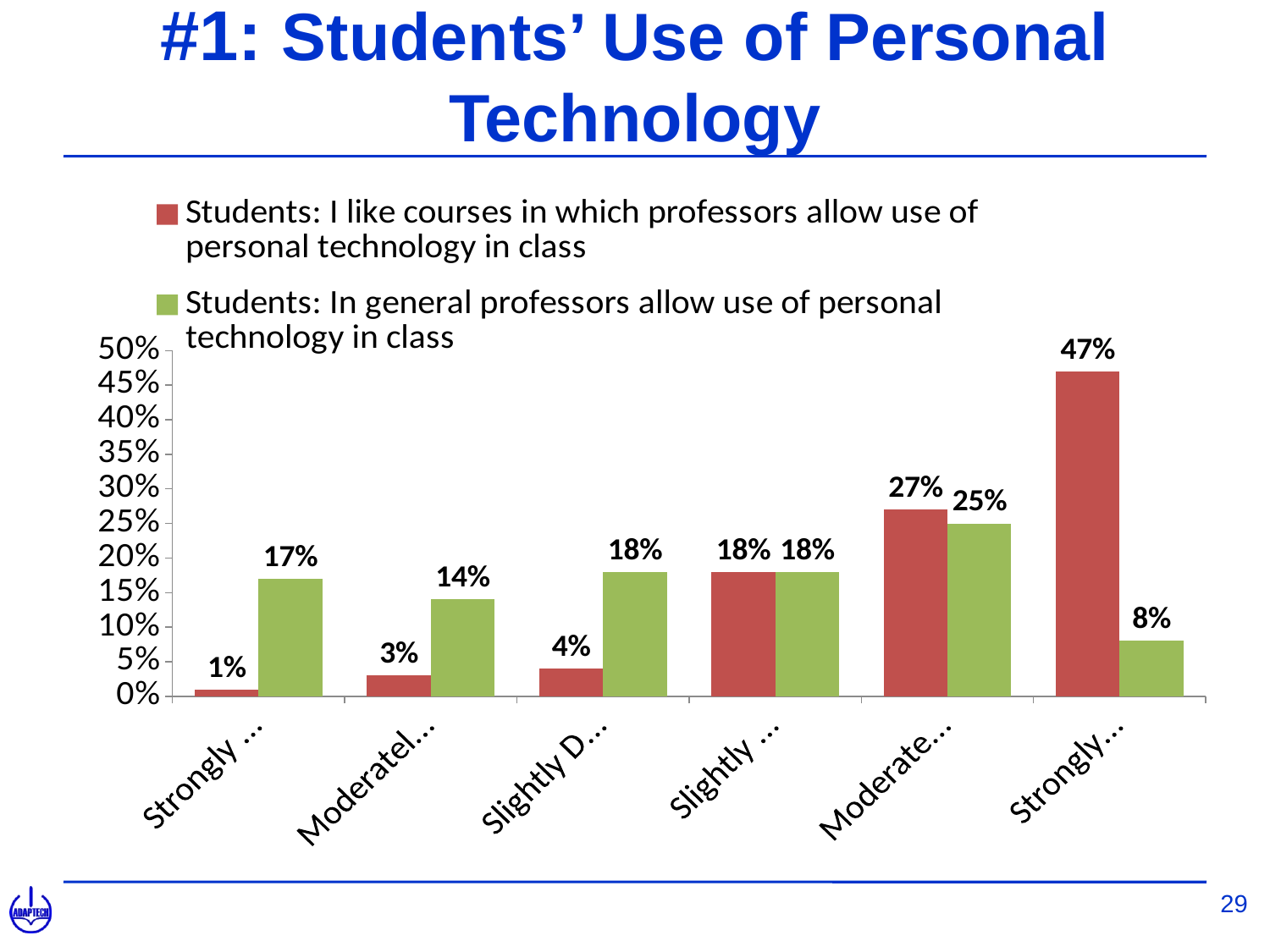
For which category is the 'I like courses in which professors allow use of personal technology in class' series highest? The rightmost category For which category is the 'In general professors allow use of personal technology in class' series lowest? The rightmost category What is the value of the 'In general professors allow use of personal technology in class' series for the leftmost category? 17% In the rightmost category, what is the difference between the 'I like courses...' value and the 'In general professors allow...' value? 39 percentage points How many categories are shown along the x axis? 6 What type of chart is shown on the slide? Bar chart What is the value of the 'I like courses in which professors allow use of personal technology in class' series for the rightmost category? 47% How many series does the legend list? 2 Does the 'I like courses in which professors allow use of personal technology in class' series rise or fall from left to right across the categories? Rise What colour represents the 'Students: In general professors allow use of personal technology in class' series? Green What is the value of the 'I like courses in which professors allow use of personal technology in class' series for the leftmost category? 1% In the fifth category from the left, which series has the larger value? Students: I like courses in which professors allow use of personal technology in class